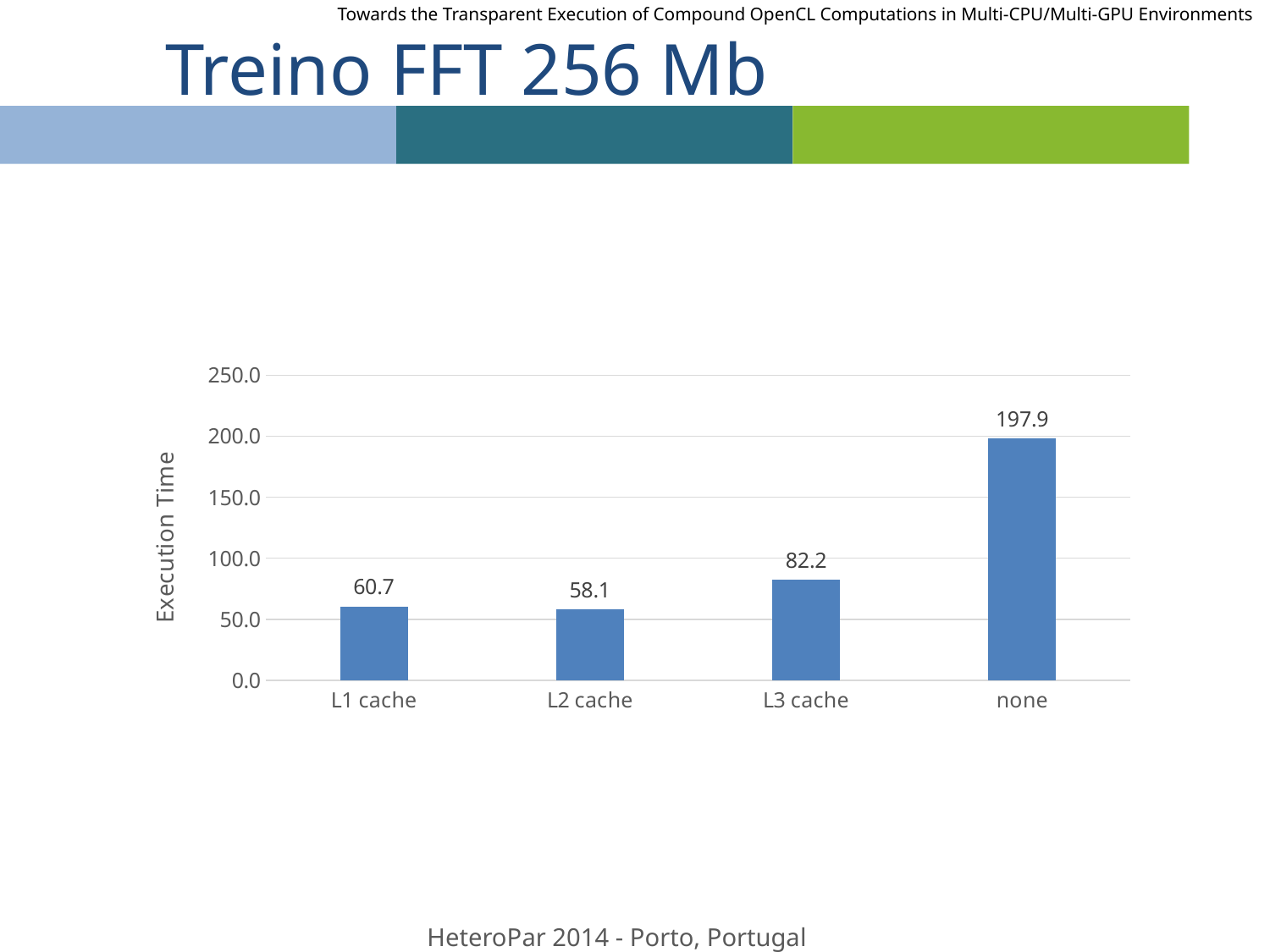
How many categories are shown on the x axis? 4 Which category has the highest execution time? none Which has a larger execution time, L3 cache or L1 cache? L3 cache What is the difference in execution time between L1 cache and L2 cache? 2.6 Which category has the lowest execution time? L2 cache What is the execution time for L2 cache? 58.1 Is the execution time for none greater or less than 150.0? greater What kind of chart is shown on the slide? bar chart What is the execution time for L1 cache? 60.7 What is the execution time for none? 197.9 What is the execution time for L3 cache? 82.2 What is the difference in execution time between none and L3 cache? 115.7